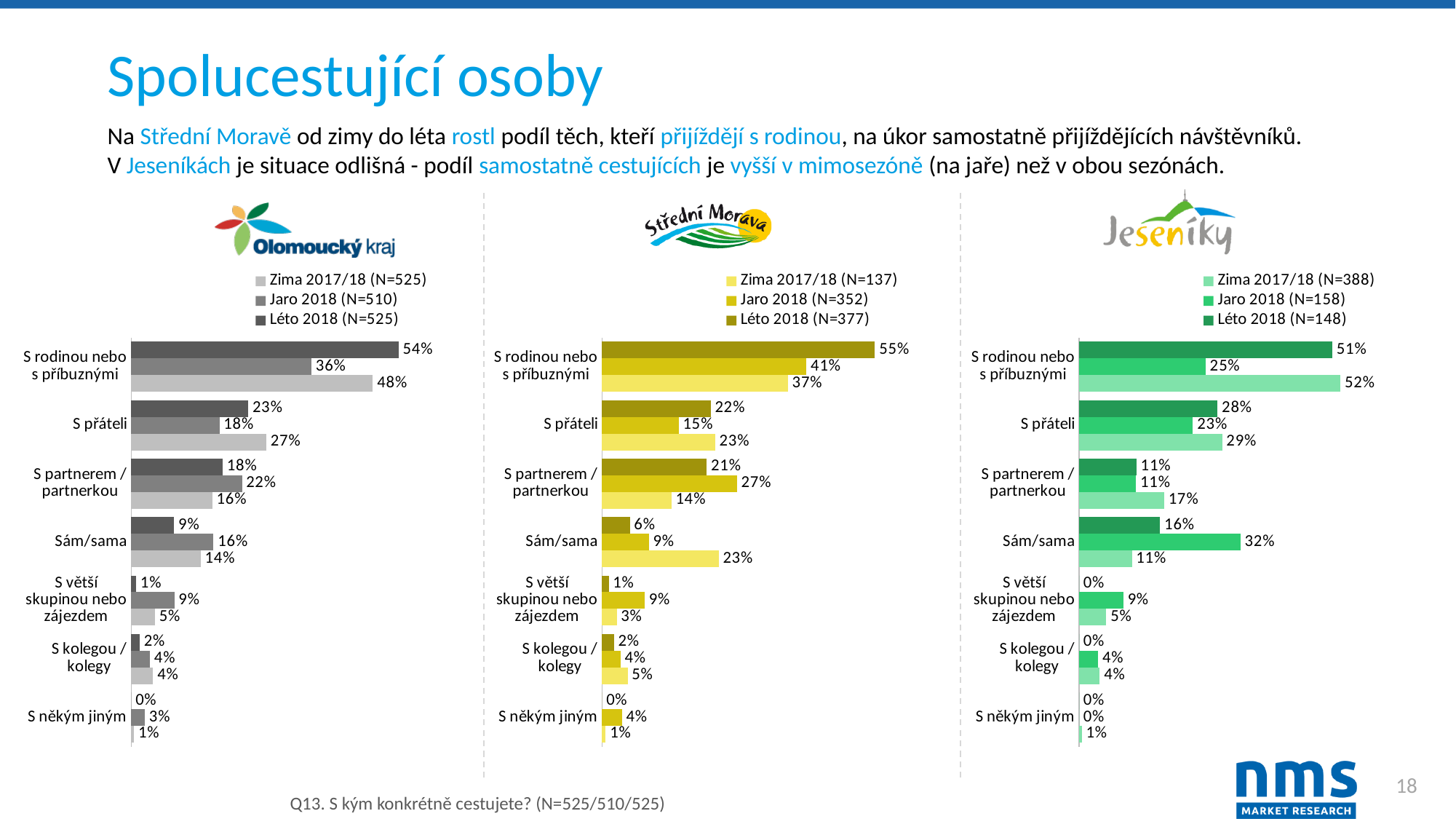
In the Jeseníky chart, what is the value for 'Sám/sama' in Jaro 2018? 32% In the Jeseníky chart, what is the difference between the Zima 2017/18 and Jaro 2018 values for 'S rodinou nebo s příbuznými'? 27 percentage points What type of chart is used for the Olomoucký kraj data? Bar chart What is the sample size (N) for Jaro 2018 in the Jeseníky chart legend? 158 In the Olomoucký kraj chart, what is the value for 'S přáteli' in Zima 2017/18? 27% How many categories are shown in the Jeseníky chart? 7 In the Střední Morava chart, which is larger for 'Sám/sama': the Zima 2017/18 value or the Léto 2018 value? Zima 2017/18 In the Olomoucký kraj chart, what is the difference between the Léto 2018 and Jaro 2018 values for 'S rodinou nebo s příbuznými'? 18 percentage points How many series does the legend of the Střední Morava chart list? 3 In the Střední Morava chart, what is the value for 'S rodinou nebo s příbuznými' in Léto 2018? 55% In the Střední Morava chart, which category has the lowest value for Zima 2017/18? S někým jiným In the Olomoucký kraj chart, which category has the highest value for Léto 2018? S rodinou nebo s příbuznými